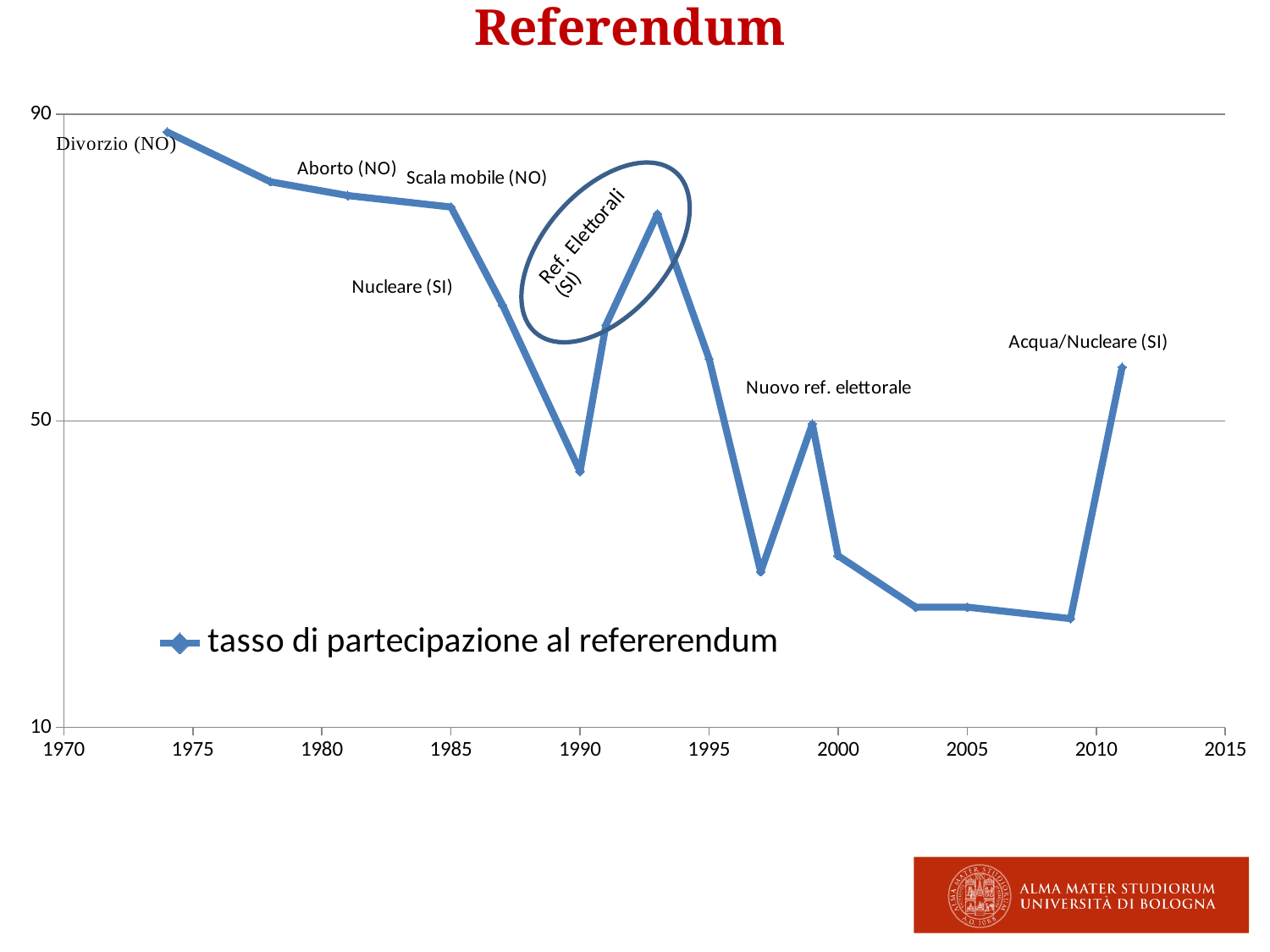
Which referendum has the highest participation rate on the chart? Divorzio (NO) Is the participation rate for the 1974 referendum (Divorzio) greater or less than 50? greater Is the participation rate for the 1990 referendum greater or less than 50? less Is the participation rate for the Acqua/Nucleare (SI) referendum in 2011 greater or less than 50? greater What kind of chart is shown on the slide? line chart How many series does the legend list? 1 Which has the higher participation rate: the 1990 referendum or the 1993 referendum (Ref. Elettorali)? 1993 (Ref. Elettorali) Which has the higher participation rate: the 1974 referendum (Divorzio) or the 2011 referendum (Acqua/Nucleare)? 1974 (Divorzio) What series name does the legend show? tasso di partecipazione al refererendum What is the title of the chart? Referendum Does the participation rate generally rise or fall from 1974 to 2009? fall